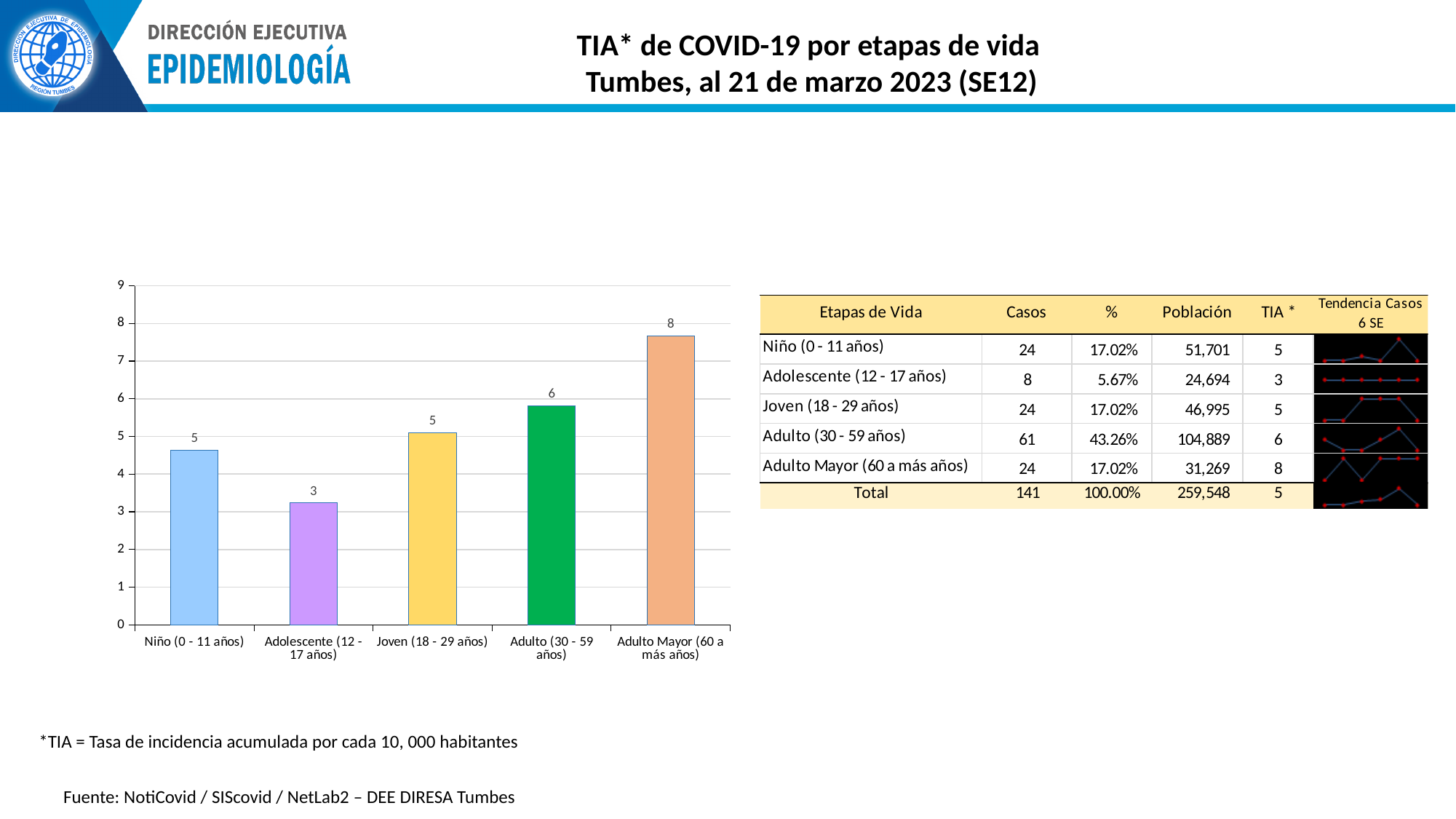
What is the TIA value shown for Adulto Mayor (60 a más años) in the bar chart? 8 Which has a larger value in the bar chart, Adulto (30 - 59 años) or Joven (18 - 29 años)? Adulto (30 - 59 años) How many life-stage categories are plotted in the bar chart? 5 Which life stage has the highest bar in the chart? Adulto Mayor (60 a más años) Is the bar for Adolescente (12 - 17 años) greater or less than 4? less Is the bar for Adulto Mayor (60 a más años) greater or less than 7? greater What is the TIA value shown for Adolescente (12 - 17 años) in the bar chart? 3 What kind of chart is used to show the TIA by life stage? bar chart What is the TIA value shown for Adulto (30 - 59 años) in the bar chart? 6 What is the difference between the labelled values for Adulto Mayor (60 a más años) and Adolescente (12 - 17 años)? 5 What colour is the bar for Adulto (30 - 59 años)? green Which life stage has the lowest bar in the chart? Adolescente (12 - 17 años)